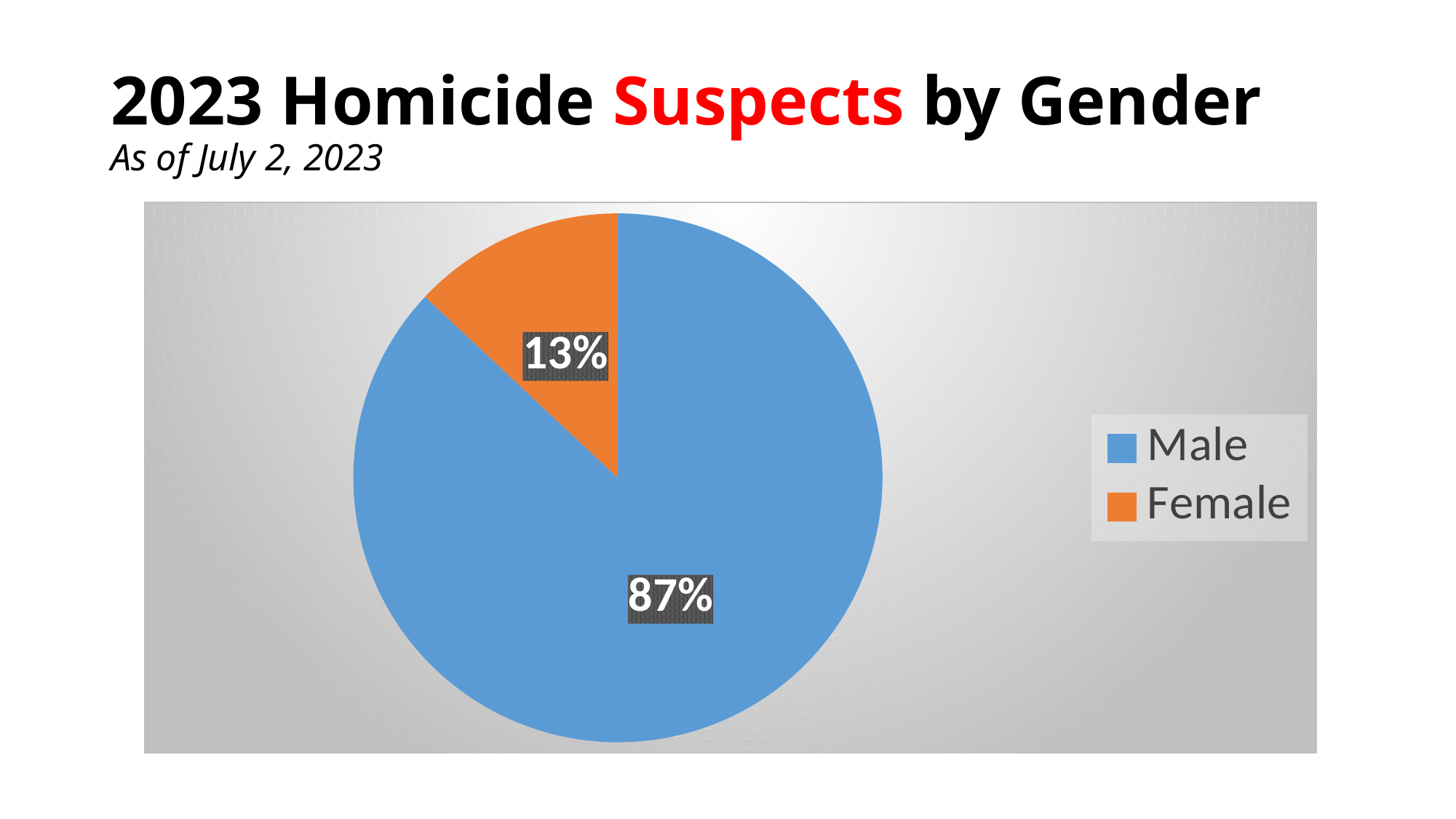
How many entries does the legend list? 2 What is the difference in percentage points between the Male and Female shares? 74 How many categories does the pie chart show? 2 What colour represents Female in the pie chart? orange Which is larger, the Male share or the Female share? Male Which gender has the largest share of homicide suspects? Male What share of homicide suspects are Female? 13% What kind of chart is shown on the slide? pie chart Which gender has the smallest share of homicide suspects? Female What share of homicide suspects are Male? 87% What is the title of the slide? 2023 Homicide Suspects by Gender